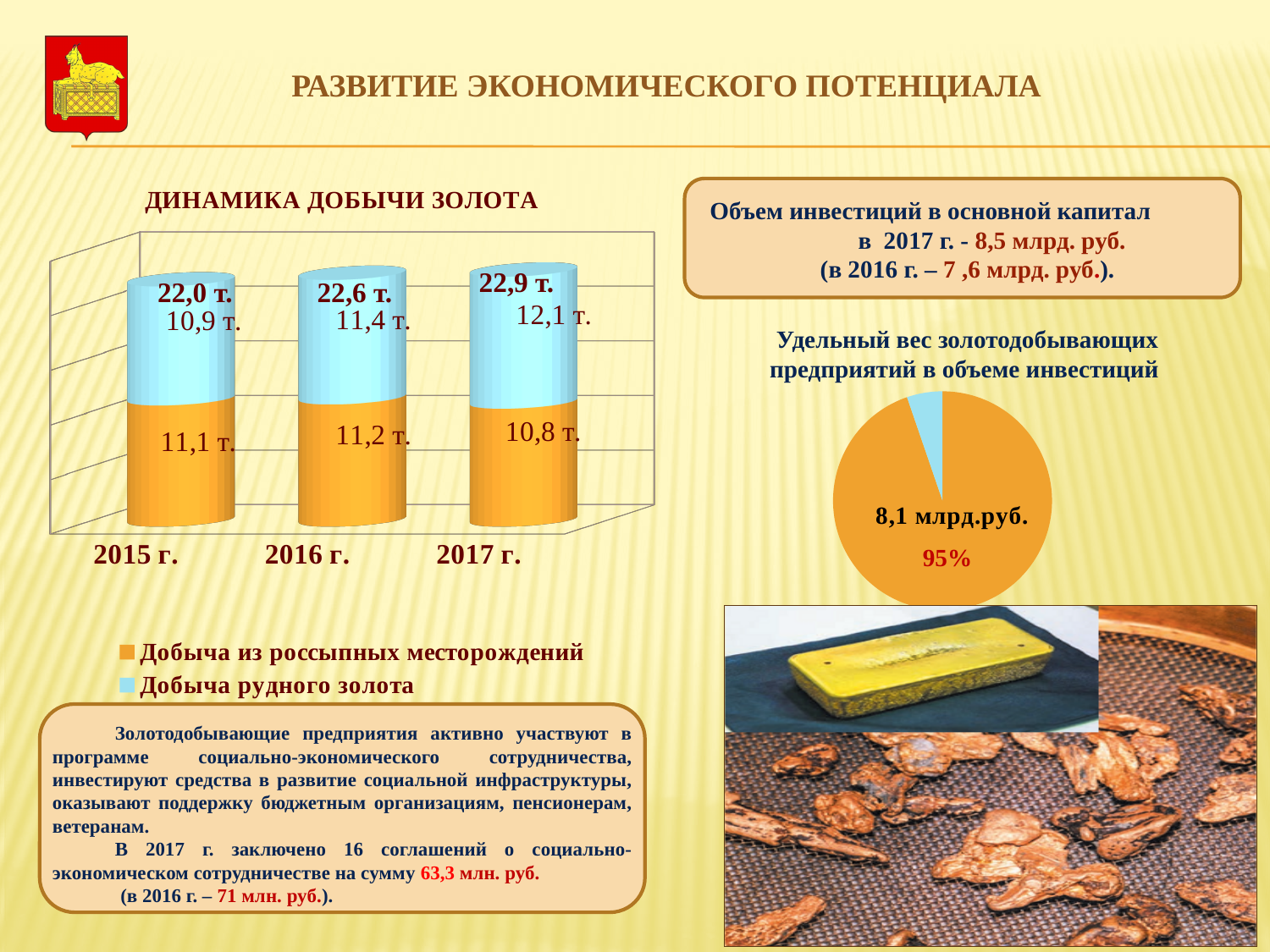
In the chart 'ДИНАМИКА ДОБЫЧИ ЗОЛОТА', what is the value of 'Добыча рудного золота' for 2017 г.? 12,1 т. In the chart 'ДИНАМИКА ДОБЫЧИ ЗОЛОТА', what is the difference between 'Добыча рудного золота' in 2017 г. and in 2015 г.? 1,2 т. In the chart 'ДИНАМИКА ДОБЫЧИ ЗОЛОТА', how many series does the legend list? 2 In the chart 'ДИНАМИКА ДОБЫЧИ ЗОЛОТА', what is the value of 'Добыча из россыпных месторождений' for 2015 г.? 11,1 т. In the chart 'ДИНАМИКА ДОБЫЧИ ЗОЛОТА', how many years are shown on the x axis? 3 In the chart 'ДИНАМИКА ДОБЫЧИ ЗОЛОТА', which is larger in 2017 г.: 'Добыча рудного золота' or 'Добыча из россыпных месторождений'? Добыча рудного золота In the chart 'ДИНАМИКА ДОБЫЧИ ЗОЛОТА', what is the total gold production shown for 2016 г.? 22,6 т. In the pie chart 'Удельный вес золотодобывающих предприятий в объеме инвестиций', what share does the large orange slice represent? 95% What kind of chart is 'ДИНАМИКА ДОБЫЧИ ЗОЛОТА'? Stacked bar chart In the chart 'ДИНАМИКА ДОБЫЧИ ЗОЛОТА', does the total gold production rise or fall from 2015 г. to 2017 г.? Rises In the chart 'ДИНАМИКА ДОБЫЧИ ЗОЛОТА', which year has the lowest value for 'Добыча рудного золота'? 2015 г. In the chart 'ДИНАМИКА ДОБЫЧИ ЗОЛОТА', which year has the highest total gold production? 2017 г.